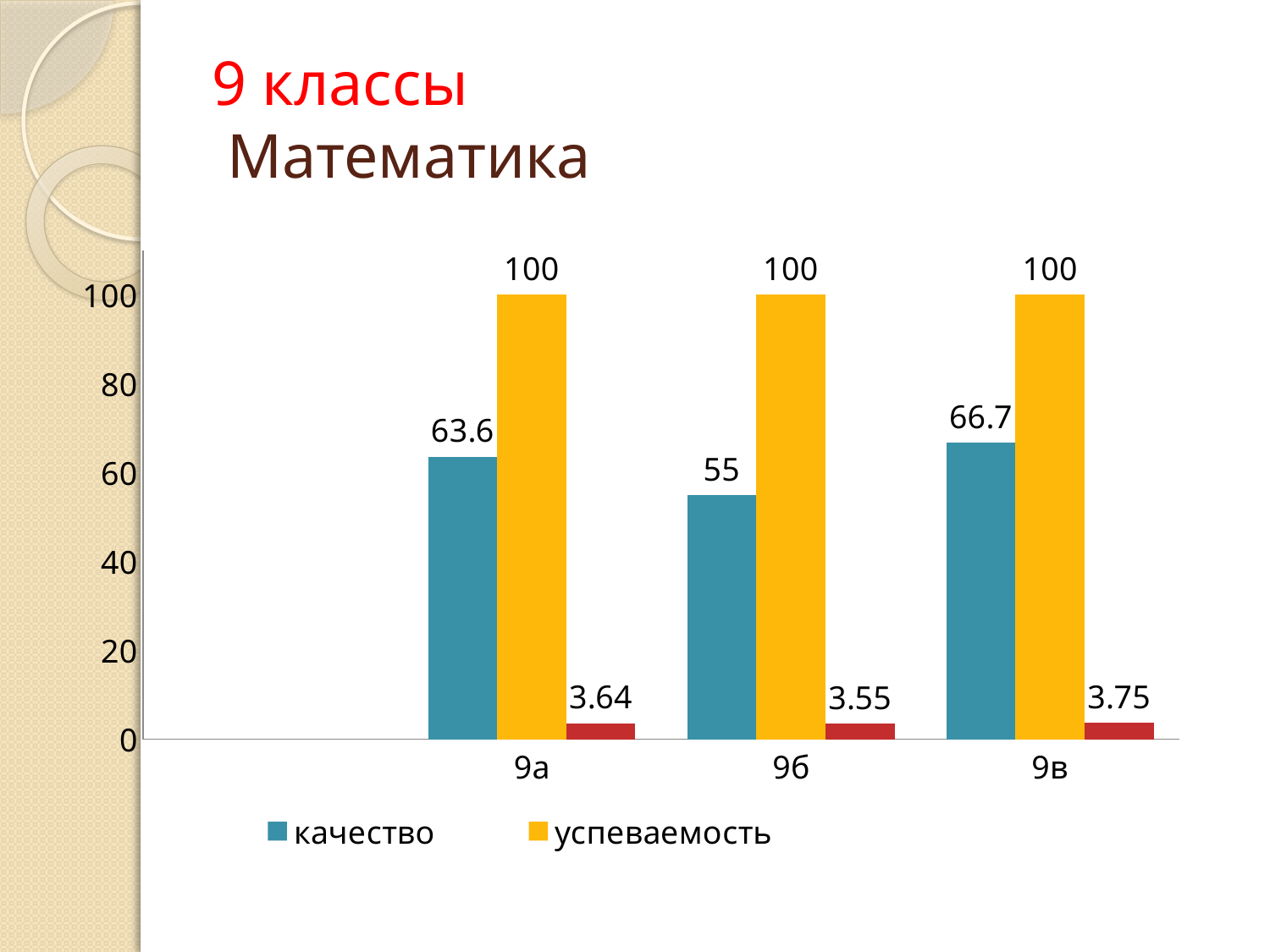
Which class has the lowest качество value? 9б What is the value of успеваемость for 9б? 100 What kind of chart is shown on the slide? bar chart How many classes are shown on the x axis? 3 What is the value of качество for 9б? 55 Which class has the highest качество value? 9в Which is larger, the качество value for 9а or for 9б? 9а What is the value printed above the red bar for 9в? 3.75 How many series does the legend list? 2 What is the value of качество for 9а? 63.6 What is the value of качество for 9в? 66.7 What is the difference between the качество values for 9в and 9б? 11.7